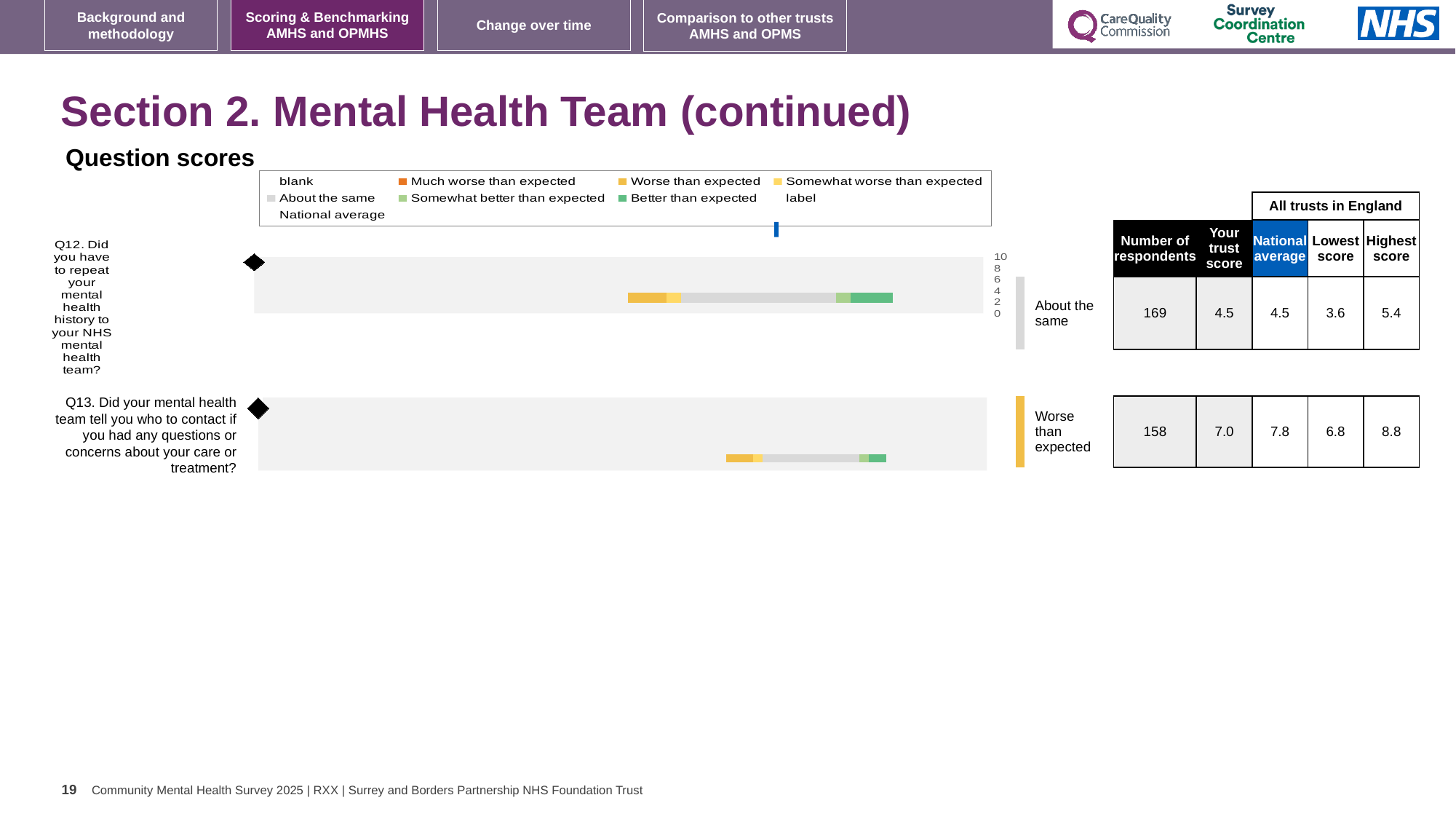
How many questions (categories) are plotted in the question scores chart? 2 What kind of chart is used to show the question scores on this slide? bar chart In the table beside the chart, what is the number of respondents for Q12? 169 What colour is the legend marker for "Better than expected" in the question scores chart? green How many entries does the legend of the question scores chart list? 9 In the table beside the chart, what is the difference between the highest score and the lowest score for Q13? 2.0 In the table beside the chart, what is the national average for Q13? 7.8 What is the heading shown above the chart on this slide? Question scores What benchmark category label is shown to the right of the bar for Q12? About the same For Q13, which is larger in the table: the trust's score or the national average? national average In the table beside the chart, what is the trust's score for Q13? 7.0 What benchmark category label is shown to the right of the bar for Q13? Worse than expected